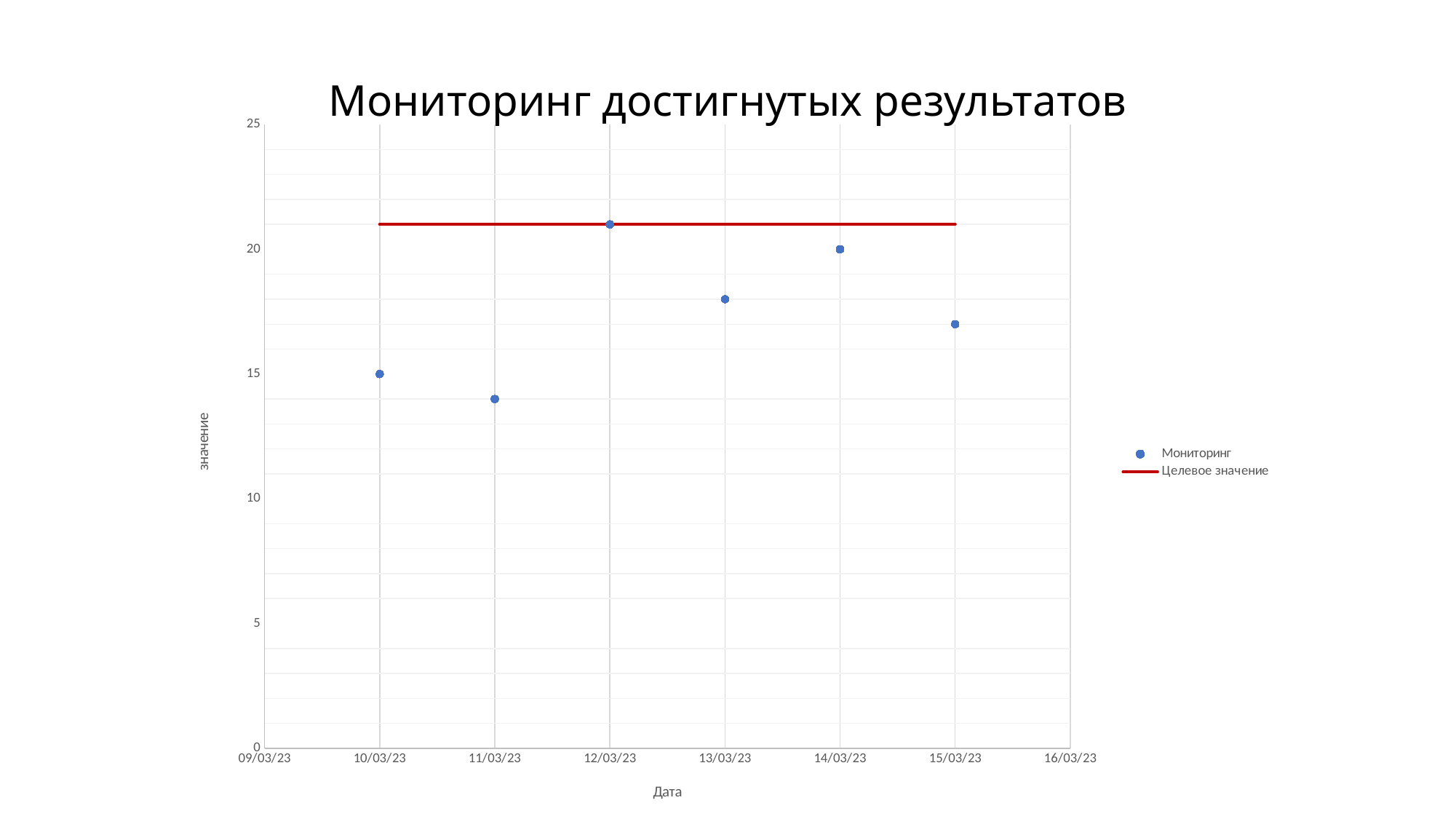
What type of chart is shown on the slide? scatter chart What is the title of the chart? Мониторинг достигнутых результатов On which date is the Мониторинг value highest? 12/03/23 On which date is the Мониторинг value lowest? 11/03/23 Is the Мониторинг value on 11/03/23 greater or less than 15? less What is the value for Мониторинг on 10/03/23? 15 Is the Мониторинг value on 12/03/23 greater or less than 20? greater Which is larger, the Мониторинг value on 12/03/23 or on 10/03/23? 12/03/23 What is the value for Мониторинг on 14/03/23? 20 How many series does the legend list? 2 What colour is the Целевое значение line? red How many data points are plotted for the Мониторинг series? 6